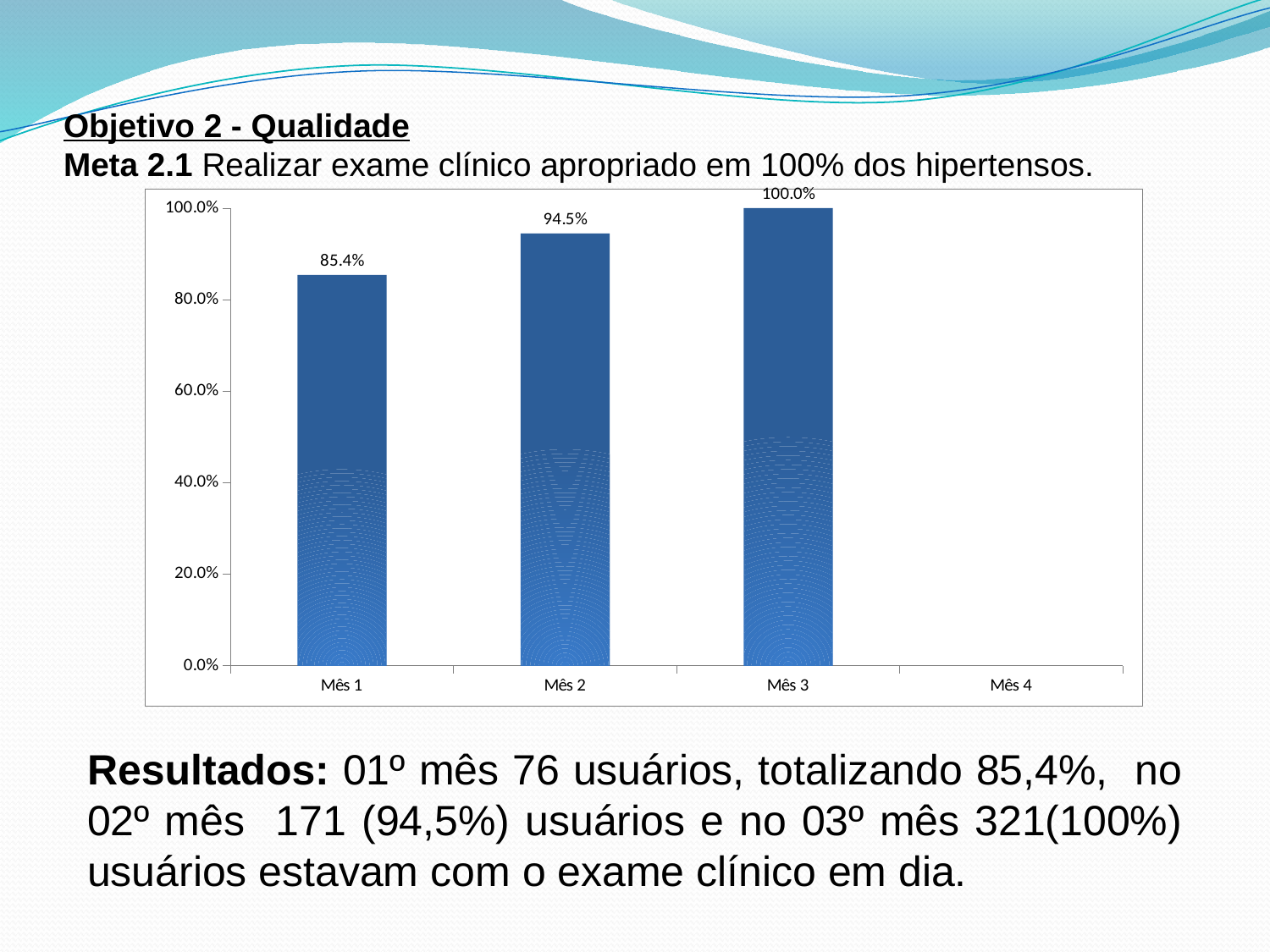
What kind of chart is shown on the slide? bar chart Do the values rise or fall from Mês 1 to Mês 3? rise How many categories are shown on the x axis? 4 What is the value for Mês 1? 85.4% What is the value for Mês 2? 94.5% Is the value for Mês 1 greater or less than 80.0%? greater Which month has the highest value? Mês 3 Which month with a plotted bar has the lowest value? Mês 1 What is the difference between the values for Mês 2 and Mês 1? 9.1% Which is larger, the value for Mês 1 or the value for Mês 2? Mês 2 What is the difference between the values for Mês 3 and Mês 1? 14.6% What is the value for Mês 3? 100.0%